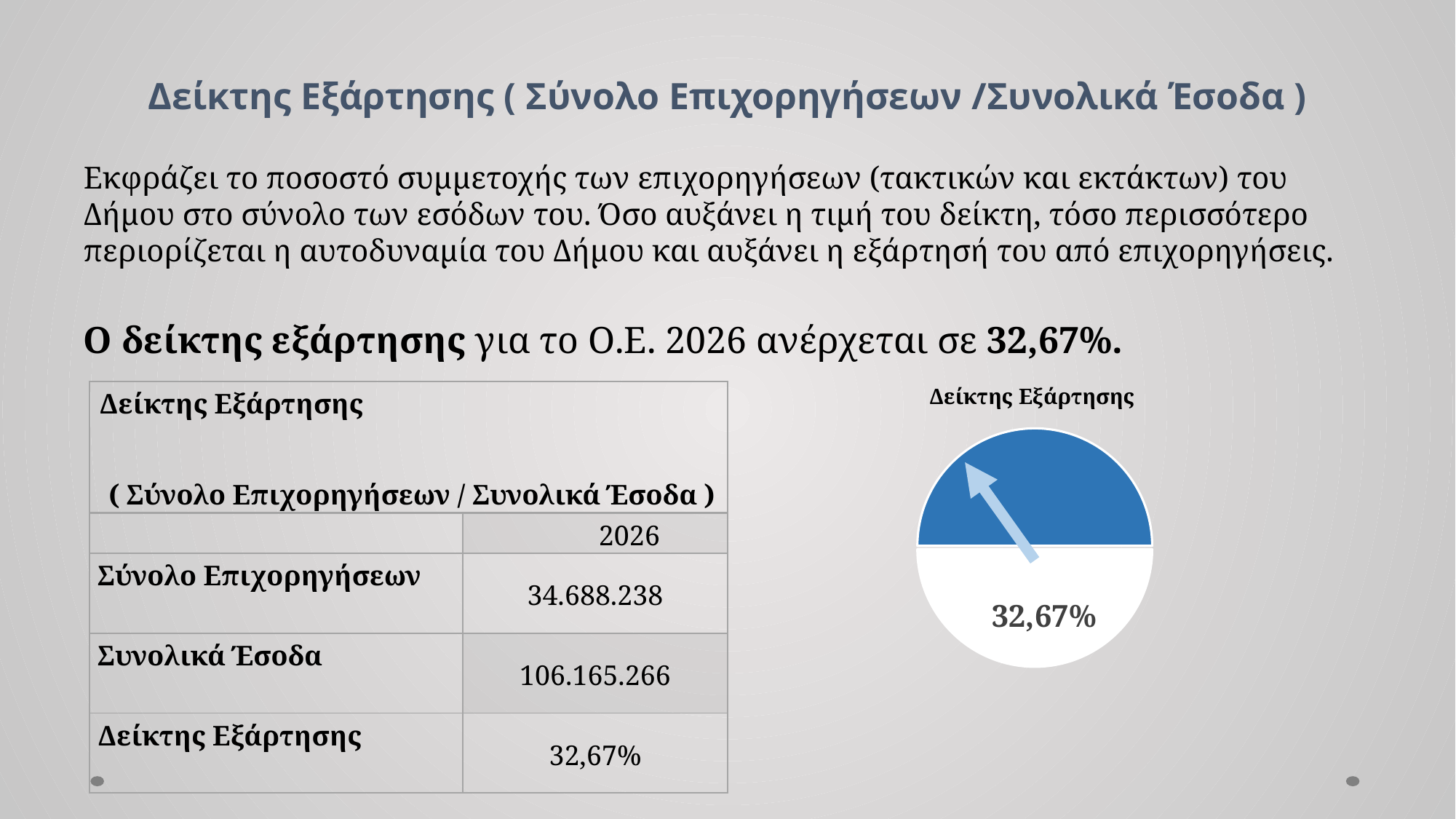
Is the percentage printed on the pie chart greater or less than 50%? less What colour is the upper slice of the pie chart? blue What percentage value is printed on the pie chart? 32,67% What kind of chart is shown on the slide? pie chart What is the title of the chart on the slide? Δείκτης Εξάρτησης How many slices does the pie chart have? 2